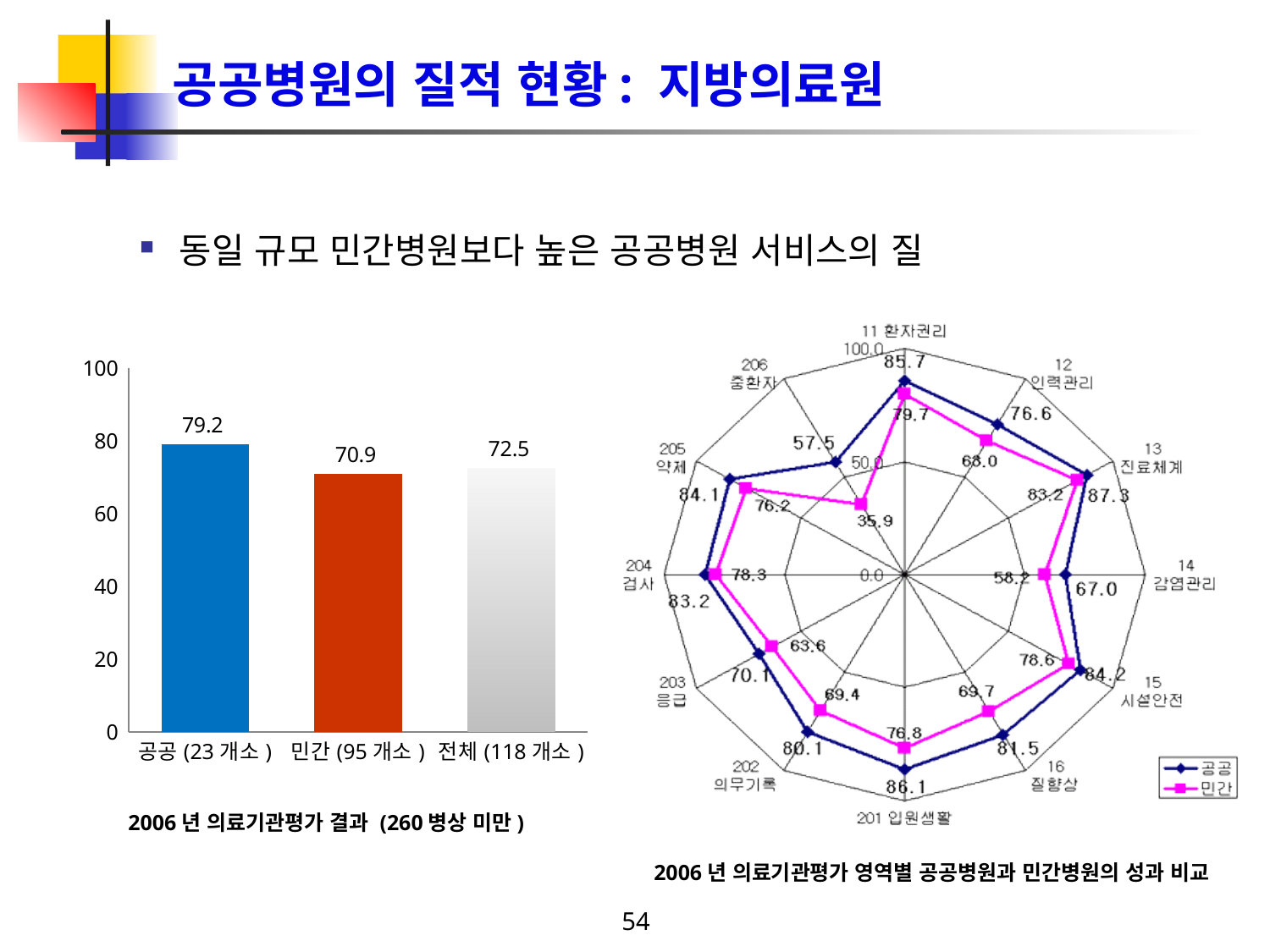
In the left bar chart, which category has the lowest value? 민간 (95 개소) In the right radar chart, what is the 민간 value for 14 감염관리? 58.2 In the right radar chart, which is larger for 16 질향상: the 공공 value or the 민간 value? 공공 How many categories does the left bar chart show? 3 In the left bar chart, which category has the highest value? 공공 (23 개소) How many series does the legend of the right radar chart list? 2 In the left bar chart, what is the value for 공공 (23 개소)? 79.2 In the right radar chart, what is the difference between the 공공 and 민간 values for 206 중환자? 21.6 What kind of chart is the chart on the left of the slide? bar chart In the left bar chart, what is the value for 민간 (95 개소)? 70.9 In the left bar chart, what is the difference between the values for 공공 (23 개소) and 민간 (95 개소)? 8.3 In the right radar chart, what is the 공공 value for 206 중환자? 57.5